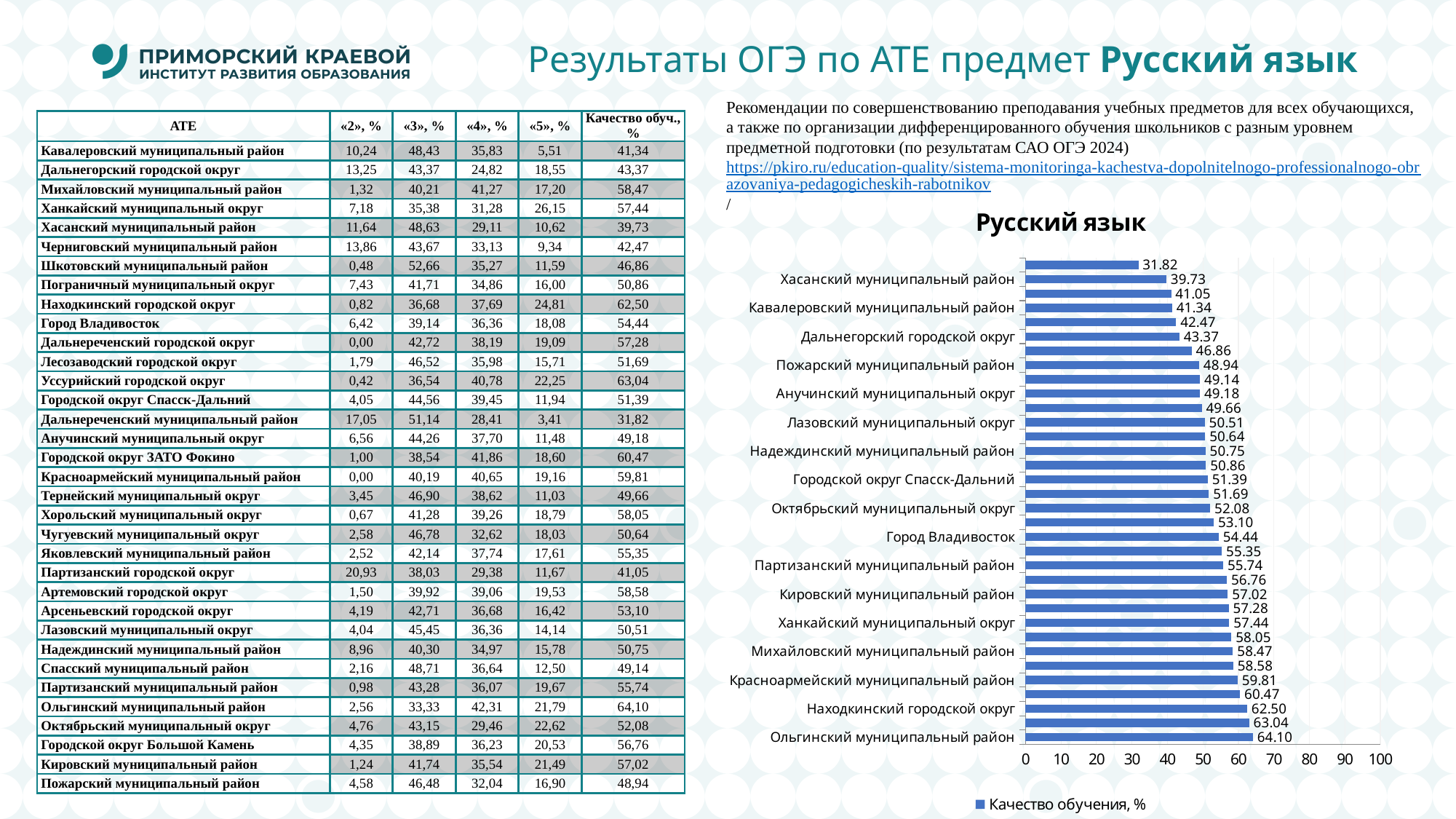
What is the value for Хасанский муниципальный район in the chart? 39.73 What is the value for Город Владивосток in the chart? 54.44 How many bars are plotted in the chart? 34 What is the difference between the values for Ольгинский муниципальный район and Находкинский городской округ? 1.60 How many series does the chart legend list? 1 What is the value for Ольгинский муниципальный район in the chart? 64.10 Which category has the highest value in the chart? Ольгинский муниципальный район Which has the larger value in the chart: Город Владивосток or Кировский муниципальный район? Кировский муниципальный район Is the value for Пожарский муниципальный район greater or less than 50? less What series name does the chart legend list? Качество обучения, % What type of chart is shown under the title "Русский язык"? bar chart What is the title of the chart on the right side of the slide? Русский язык